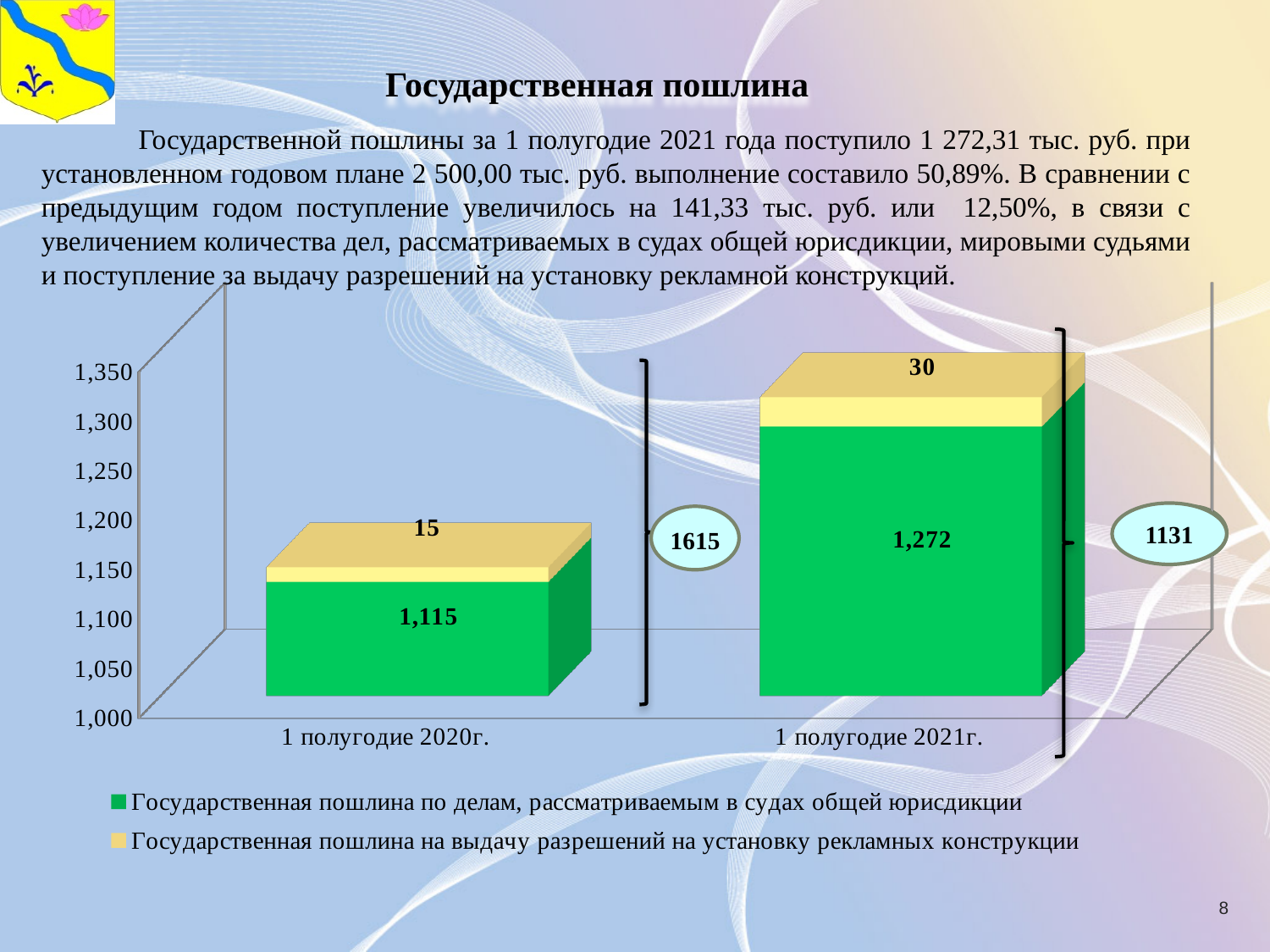
What is the value of 'Государственная пошлина на выдачу разрешений на установку рекламных конструкции' for '1 полугодие 2021г.'? 30 How many series does the chart legend list? 2 What is the value of 'Государственная пошлина по делам, рассматриваемым в судах общей юрисдикции' for '1 полугодие 2021г.'? 1,272 Which colour represents 'Государственная пошлина на выдачу разрешений на установку рекламных конструкции' in the chart? yellow What type of chart is shown on the slide? bar chart What is the value of 'Государственная пошлина на выдачу разрешений на установку рекламных конструкции' for '1 полугодие 2020г.'? 15 What is the value of 'Государственная пошлина по делам, рассматриваемым в судах общей юрисдикции' for '1 полугодие 2020г.'? 1,115 Which category has the higher value for 'Государственная пошлина на выдачу разрешений на установку рекламных конструкции', '1 полугодие 2020г.' or '1 полугодие 2021г.'? 1 полугодие 2021г. What is the total of the stacked bar for '1 полугодие 2021г.'? 1,302 By how much did the value of 'Государственная пошлина по делам, рассматриваемым в судах общей юрисдикции' change from '1 полугодие 2020г.' to '1 полугодие 2021г.'? 157 How many categories are shown on the x axis of the chart? 2 Do the values of 'Государственная пошлина по делам, рассматриваемым в судах общей юрисдикции' rise or fall from '1 полугодие 2020г.' to '1 полугодие 2021г.'? rise